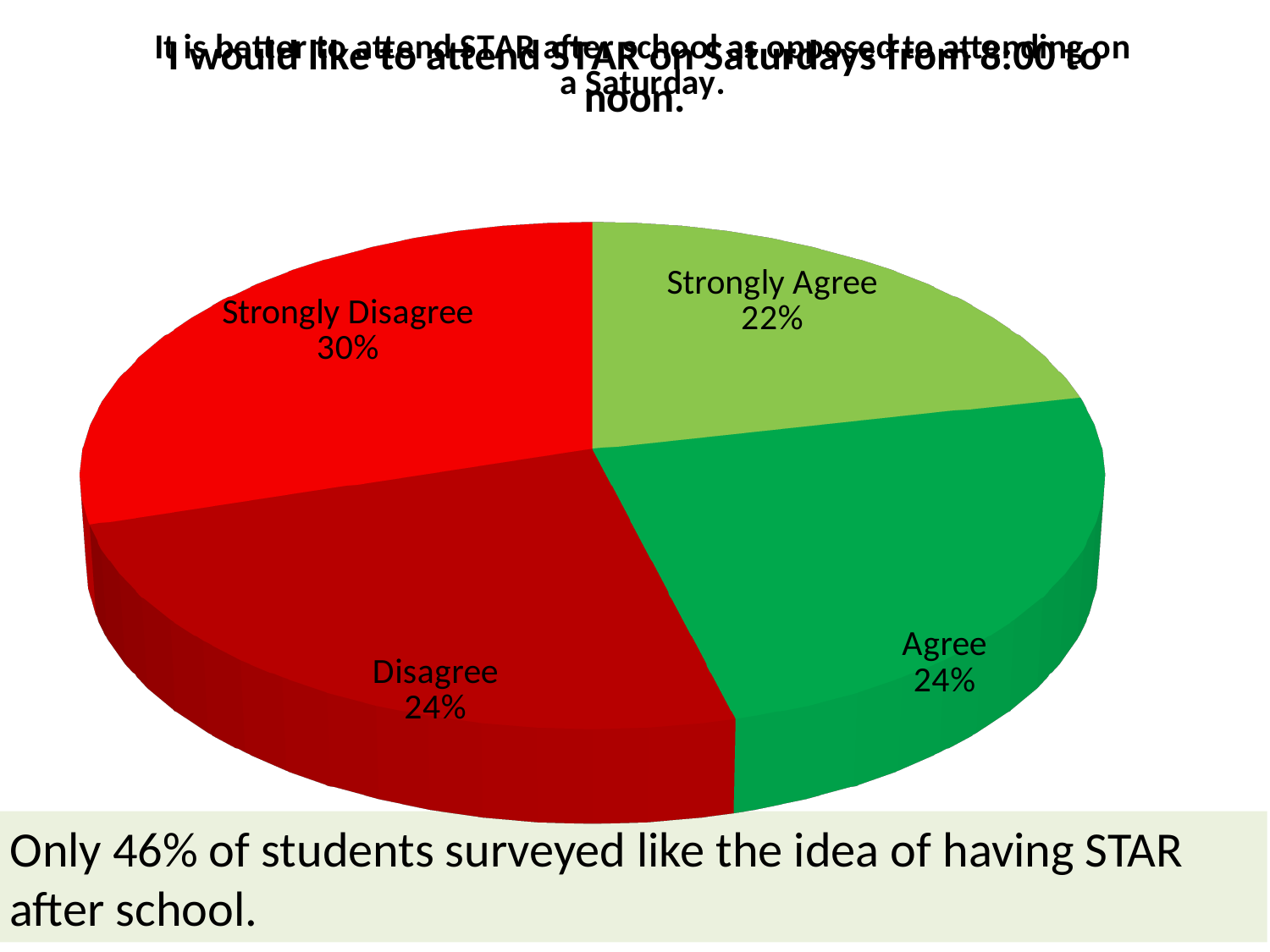
Which slice of the pie chart is the largest? Strongly Disagree Which is larger, the Strongly Disagree slice or the Agree slice? Strongly Disagree What percentage of the pie is labelled Strongly Agree? 22% What is the combined share of the Strongly Agree and Agree slices? 46% What percentage of the pie is labelled Agree? 24% How many slices does the pie chart have? 4 What percentage of the pie is labelled Strongly Disagree? 30% What kind of chart is shown on the slide? pie chart Which slice of the pie chart is the smallest? Strongly Agree What colour is the Strongly Disagree slice of the pie chart? red What percentage of the pie is labelled Disagree? 24% What is the difference in percentage points between the Strongly Disagree and Strongly Agree slices? 8